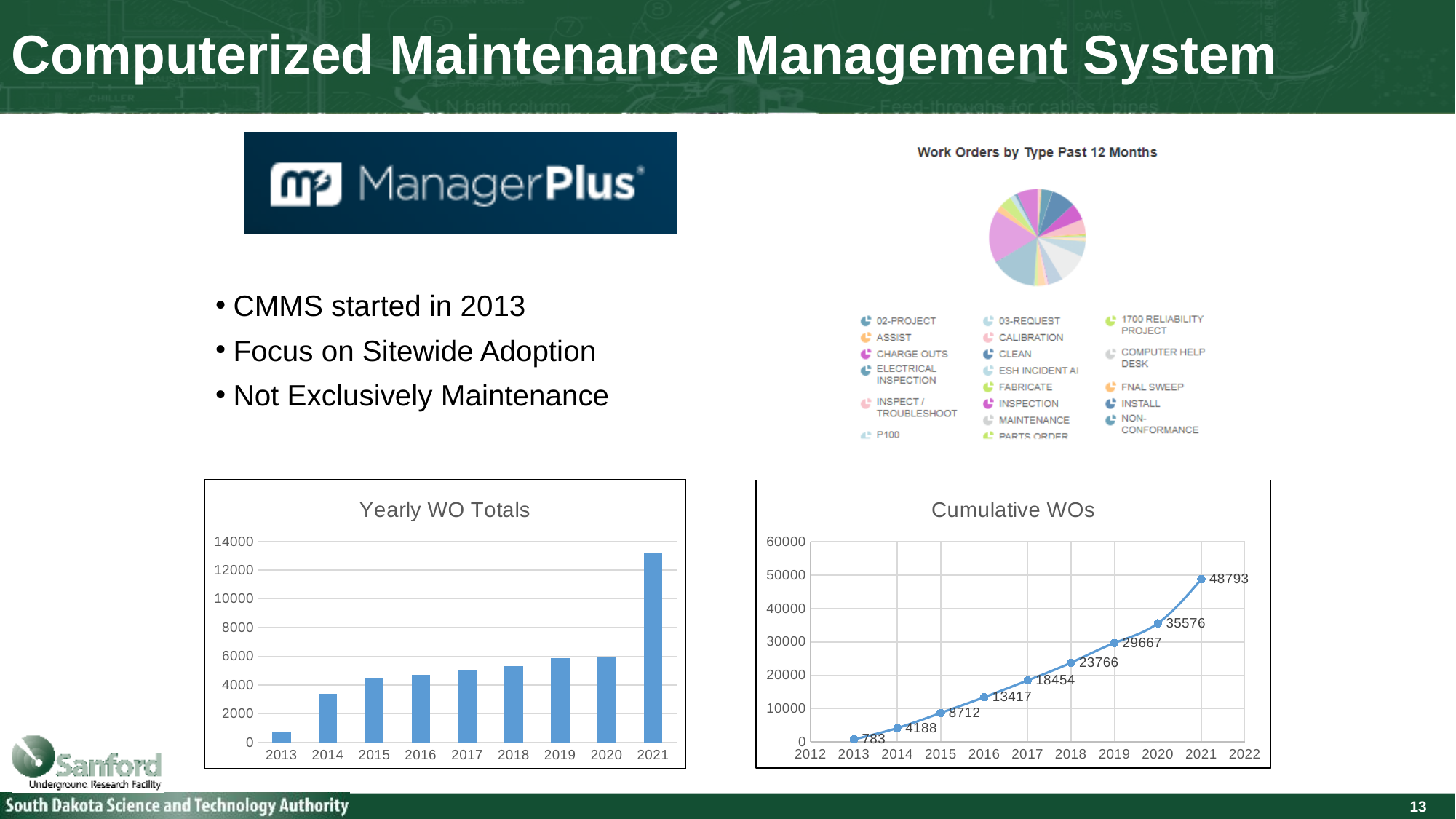
In the Yearly WO Totals chart, which year has the lowest value? 2013 In the Cumulative WOs chart, what is the value for 2021? 48793 In the Yearly WO Totals chart, is the value for 2021 greater or less than 12000? greater In the Cumulative WOs chart, what is the difference between the 2021 and 2020 values? 13217 In the Cumulative WOs chart, what is the value for 2013? 783 In the Yearly WO Totals chart, which year has the highest value? 2021 What kind of chart is the Work Orders by Type Past 12 Months chart? pie chart In the Cumulative WOs chart, how many data points are plotted? 9 In the Yearly WO Totals chart, is the value for 2014 greater or less than 4000? less In the Cumulative WOs chart, do the values rise or fall from 2013 to 2021? rise What kind of chart is the Cumulative WOs chart? line chart In the Cumulative WOs chart, what is the value for 2016? 13417